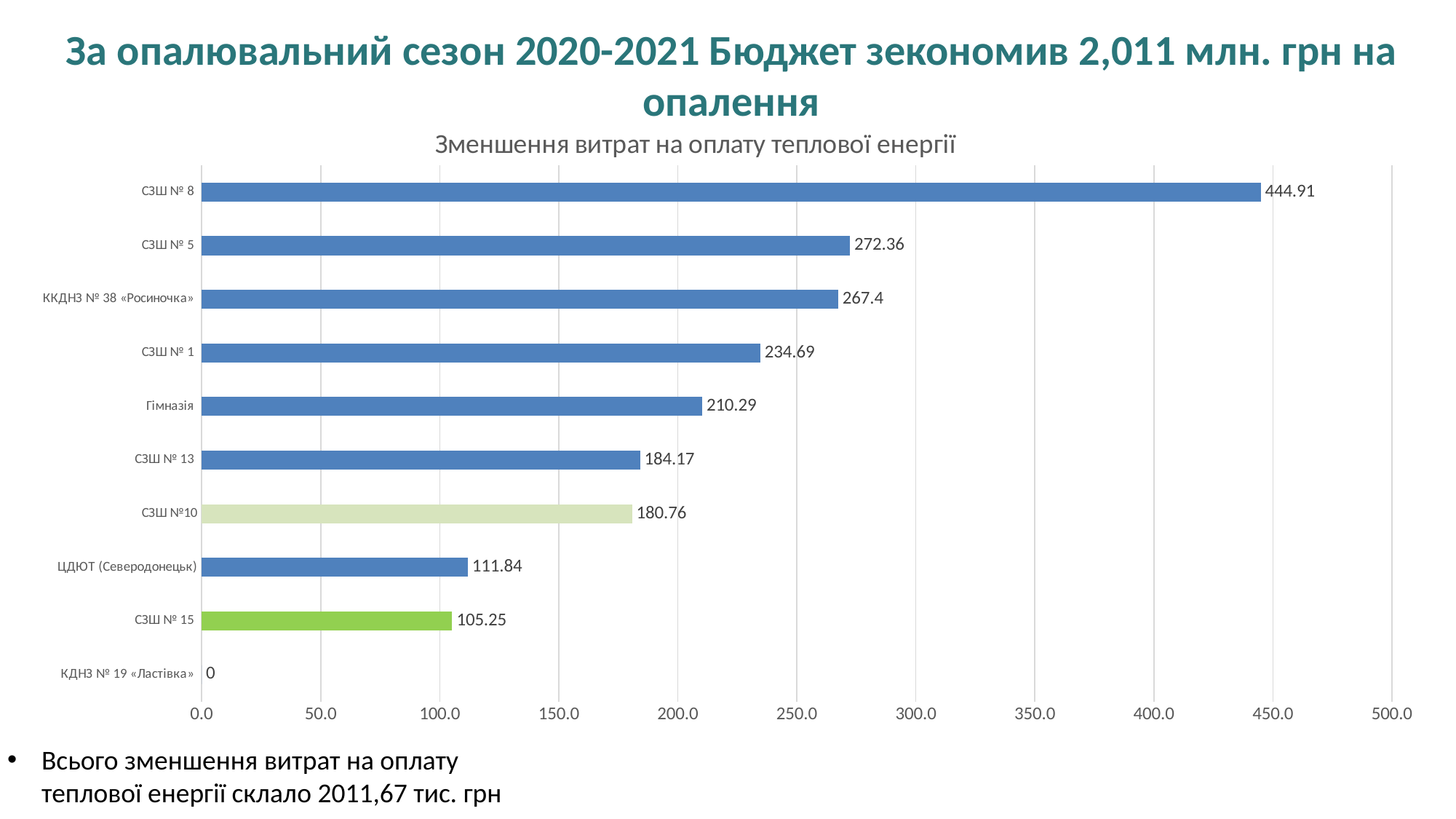
How many categories are shown in the chart? 10 What is the difference between the values for СЗШ № 8 and СЗШ № 5? 172.55 Which has a larger value, СЗШ № 1 or СЗШ № 15? СЗШ № 1 What is the value for СЗШ № 8? 444.91 What type of chart is shown on the slide? bar chart What is the value for Гімназія? 210.29 What is the value for ККДНЗ № 38 «Росиночка»? 267.4 What is the title of the chart? Зменшення витрат на оплату теплової енергії What is the value for ЦДЮТ (Северодонецьк)? 111.84 What is the difference between the values for СЗШ № 13 and СЗШ №10? 3.41 Which category has the highest value? СЗШ № 8 Which category has the lowest value? КДНЗ № 19 «Ластівка»